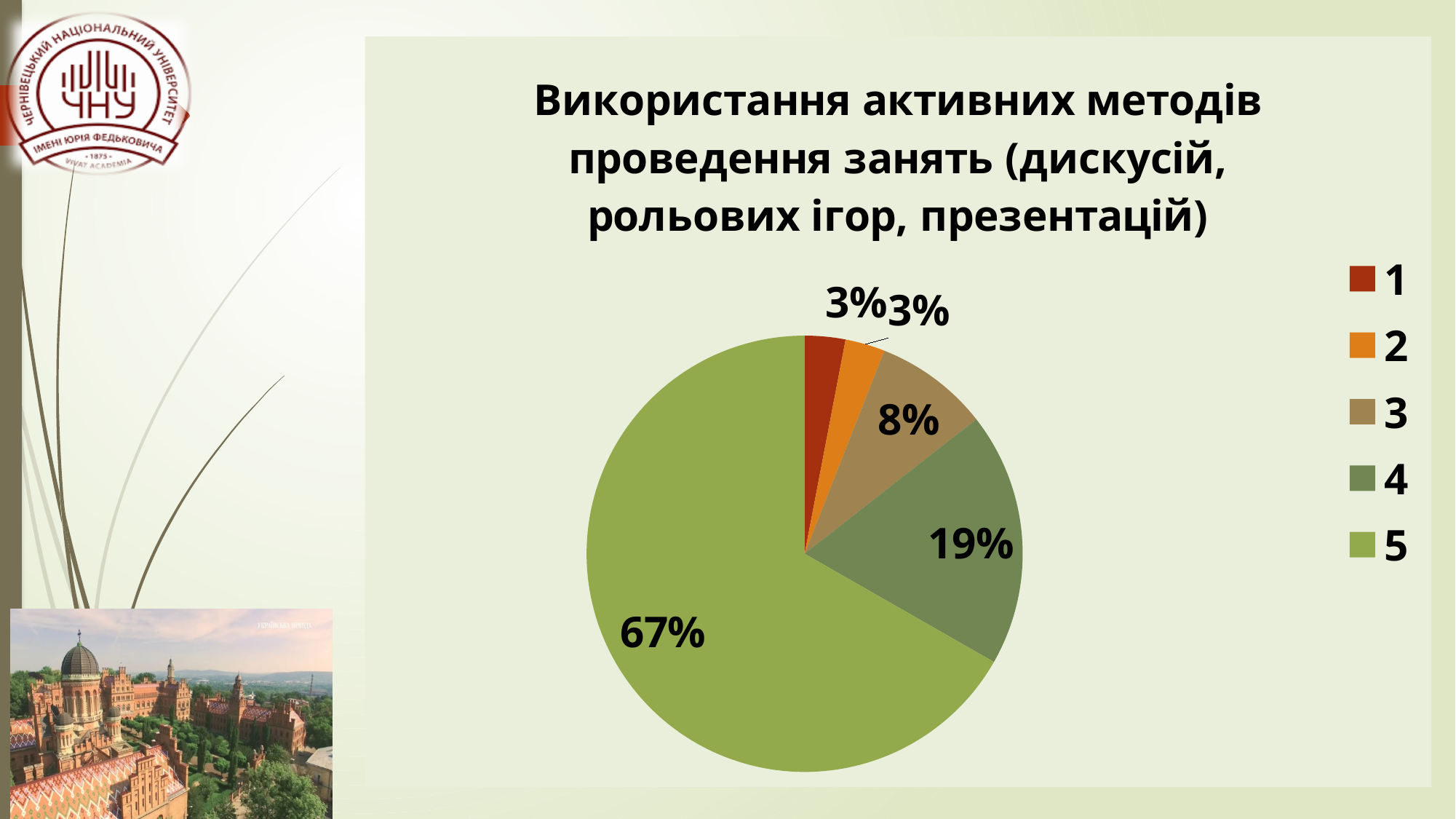
What is the difference between the shares of category 4 and category 3? 11% What share of the pie does category 4 have? 19% What is the value shown for category 3? 8% Which category has the largest slice of the pie? 5 What is the difference between the shares of category 5 and category 4? 48% What share of the pie does category 5 have? 67% What kind of chart is shown on the slide? pie chart What is the title of the chart? Використання активних методів проведення занять (дискусій, рольових ігор, презентацій) Which category has the larger slice, 3 or 4? 4 How many categories does the legend list? 5 What colour is the slice for category 1 in the legend? red What is the value shown for category 1? 3%